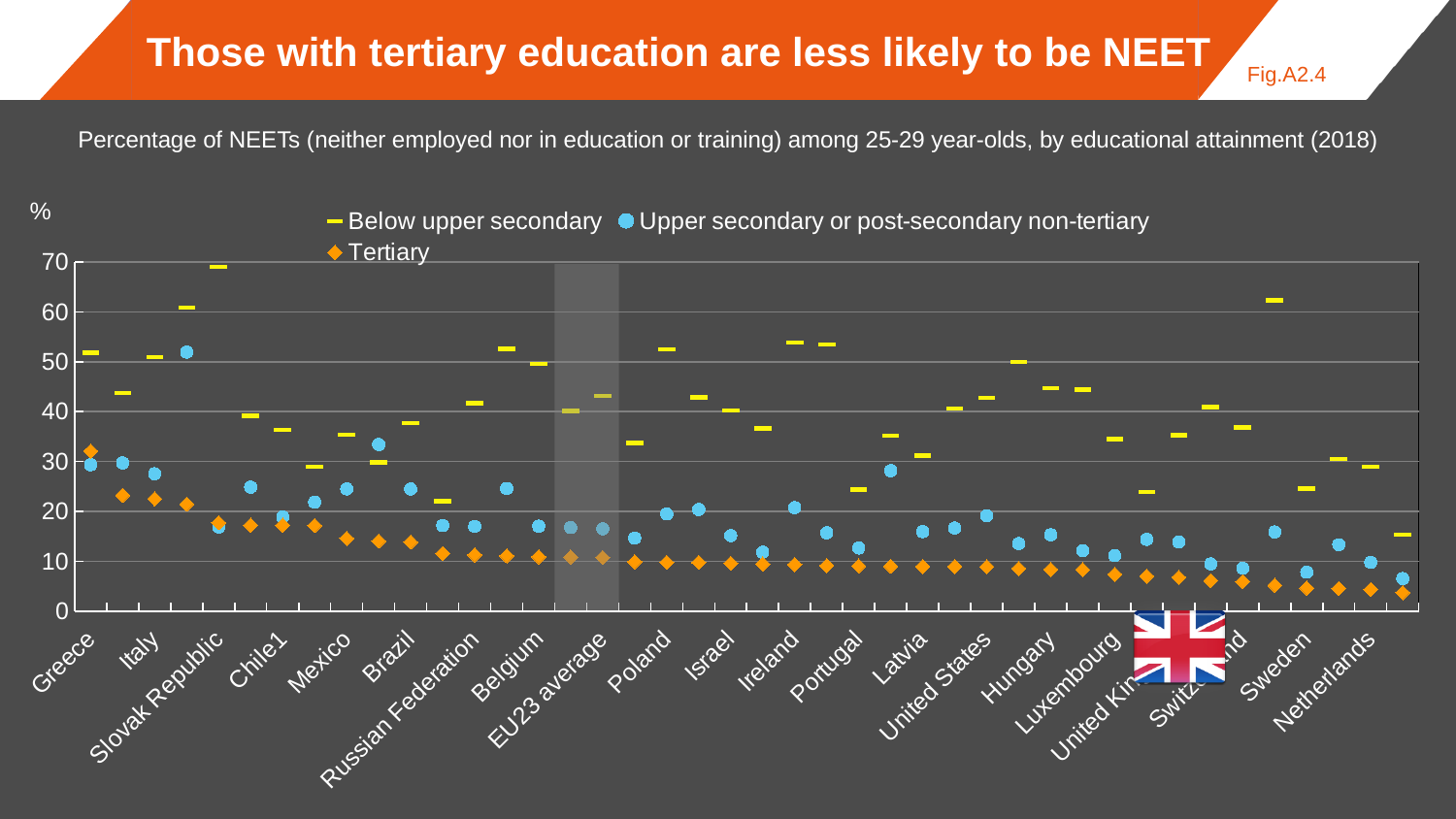
Which series is shown with orange diamond markers? Tertiary Is the Tertiary value for the Netherlands greater or less than 10? less For Greece, which is larger: the Below upper secondary value or the Upper secondary or post-secondary non-tertiary value? Below upper secondary Is the Below upper secondary value for Ireland greater or less than 50? greater Is the Tertiary value for Sweden greater or less than 10? less What is the subtitle describing the data in the chart? Percentage of NEETs (neither employed nor in education or training) among 25-29 year-olds, by educational attainment (2018) What kind of chart is shown on the slide? scatter (dot) chart How many series does the legend list? 3 Do the Tertiary values generally rise or fall moving from Greece on the left to the Netherlands on the right? fall